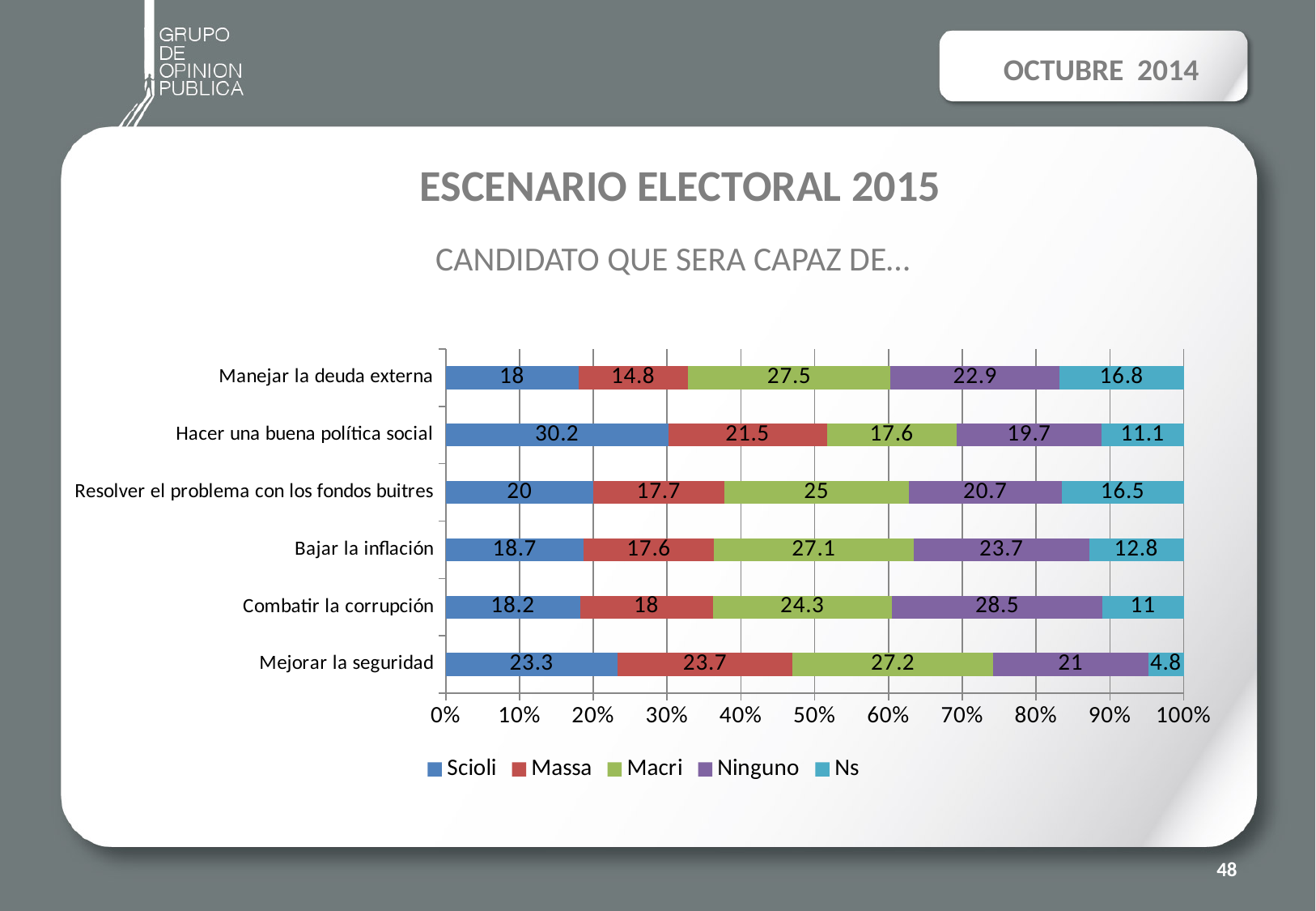
What kind of chart is shown on the slide? Stacked bar chart For which category is the Ninguno value highest? Combatir la corrupción What is the value for Ninguno in the 'Bajar la inflación' bar? 23.7 How many categories are shown on the chart? 6 For which category is the Scioli value highest? Hacer una buena política social For which category is the Ns value lowest? Mejorar la seguridad How many series does the legend list? 5 In the 'Combatir la corrupción' bar, which is larger: Ninguno or Macri? Ninguno What is the difference between the Macri and Massa values for 'Manejar la deuda externa'? 12.7 What is the value for Ns in the 'Mejorar la seguridad' bar? 4.8 What is the value for Scioli in the 'Hacer una buena política social' bar? 30.2 What is the value for Macri in the 'Resolver el problema con los fondos buitres' bar? 25